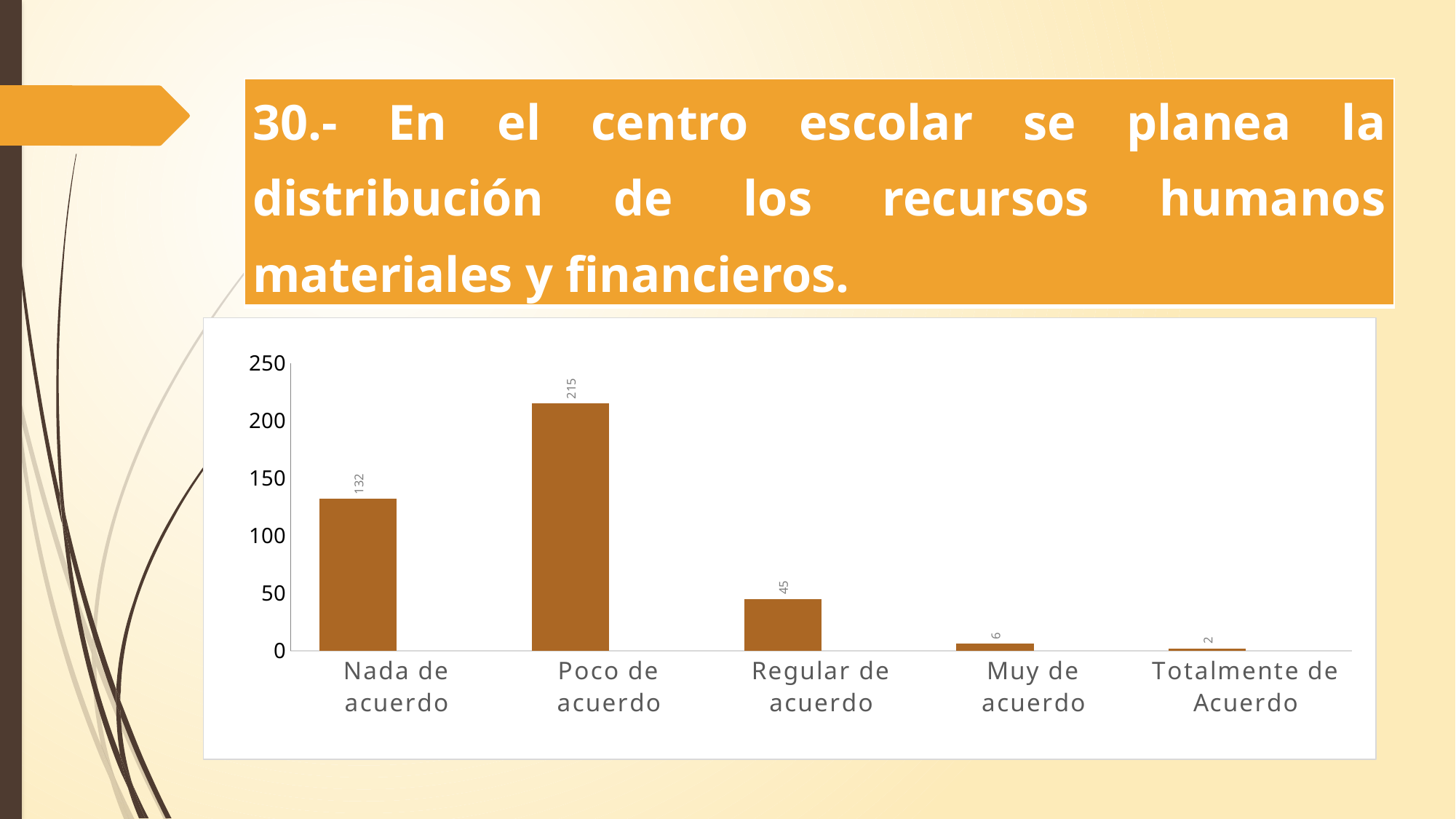
What is the difference between the values for "Poco de acuerdo" and "Nada de acuerdo"? 83 What is the value for "Totalmente de Acuerdo"? 2 What is the value for "Muy de acuerdo"? 6 Which is larger, the value for "Regular de acuerdo" or the value for "Muy de acuerdo"? Regular de acuerdo How many categories are shown on the x axis? 5 Which category has the highest value? Poco de acuerdo What kind of chart is shown on the slide? bar chart What is the value for "Regular de acuerdo"? 45 What is the value for "Nada de acuerdo"? 132 Which category has the lowest value? Totalmente de Acuerdo What is the value for "Poco de acuerdo"? 215 Is the value for "Nada de acuerdo" greater or less than 100? greater